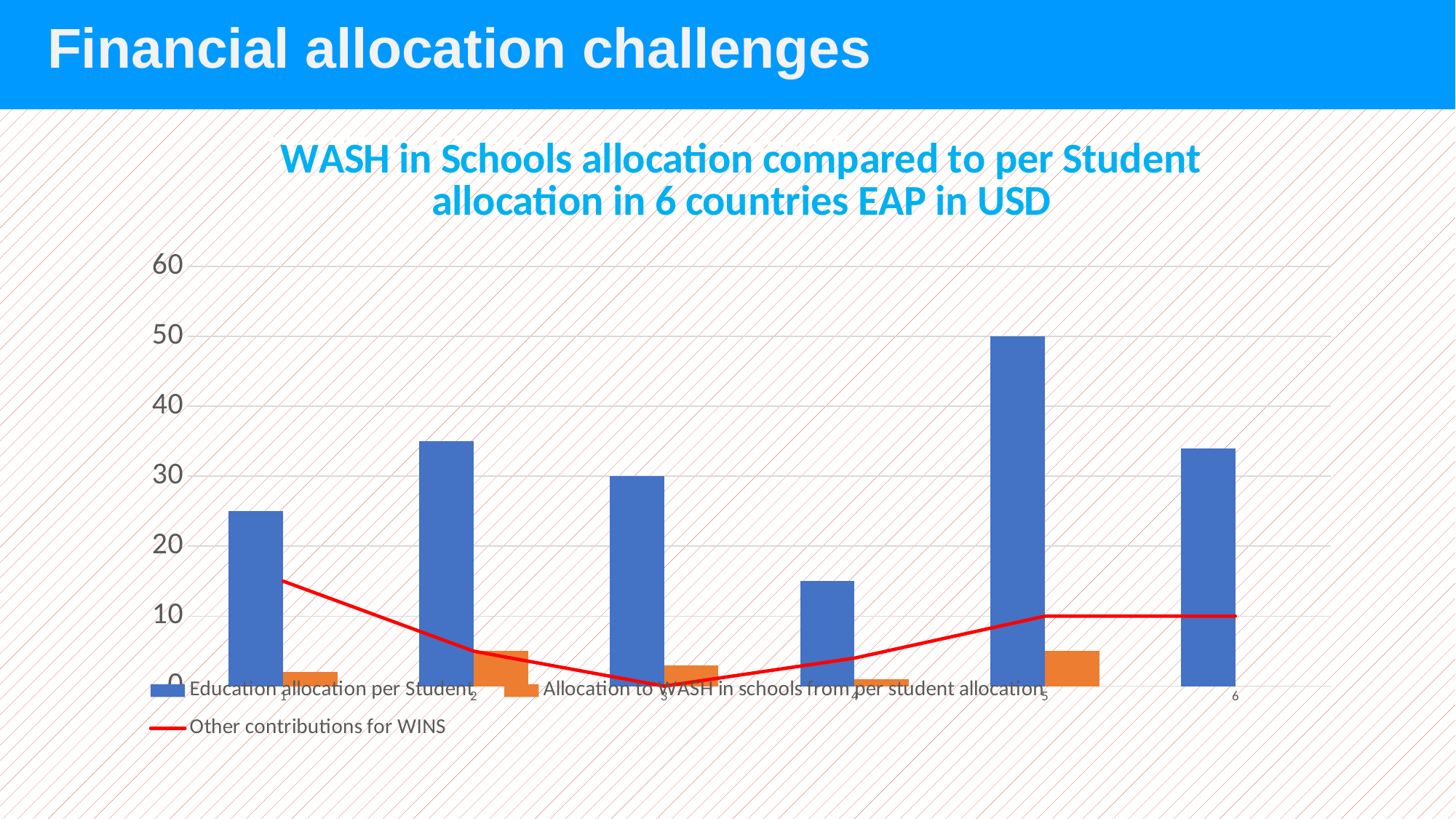
Is the Education allocation per Student for category 4 greater or less than 20? less Is the Other contributions for WINS value for category 1 greater or less than 10? greater How many categories are shown along the x axis? 6 How many series does the legend list? 3 What is the title of the chart? WASH in Schools allocation compared to per Student allocation in 6 countries EAP in USD Which category has the lowest Education allocation per Student? 4 Which category has the highest Education allocation per Student? 5 Is the Education allocation per Student for category 1 greater or less than 20? greater Which is larger, the Education allocation per Student for category 2 or for category 3? Category 2 What kind of chart is shown on the slide? A bar chart combined with a line Which is larger, the Education allocation per Student for category 1 or for category 4? Category 1